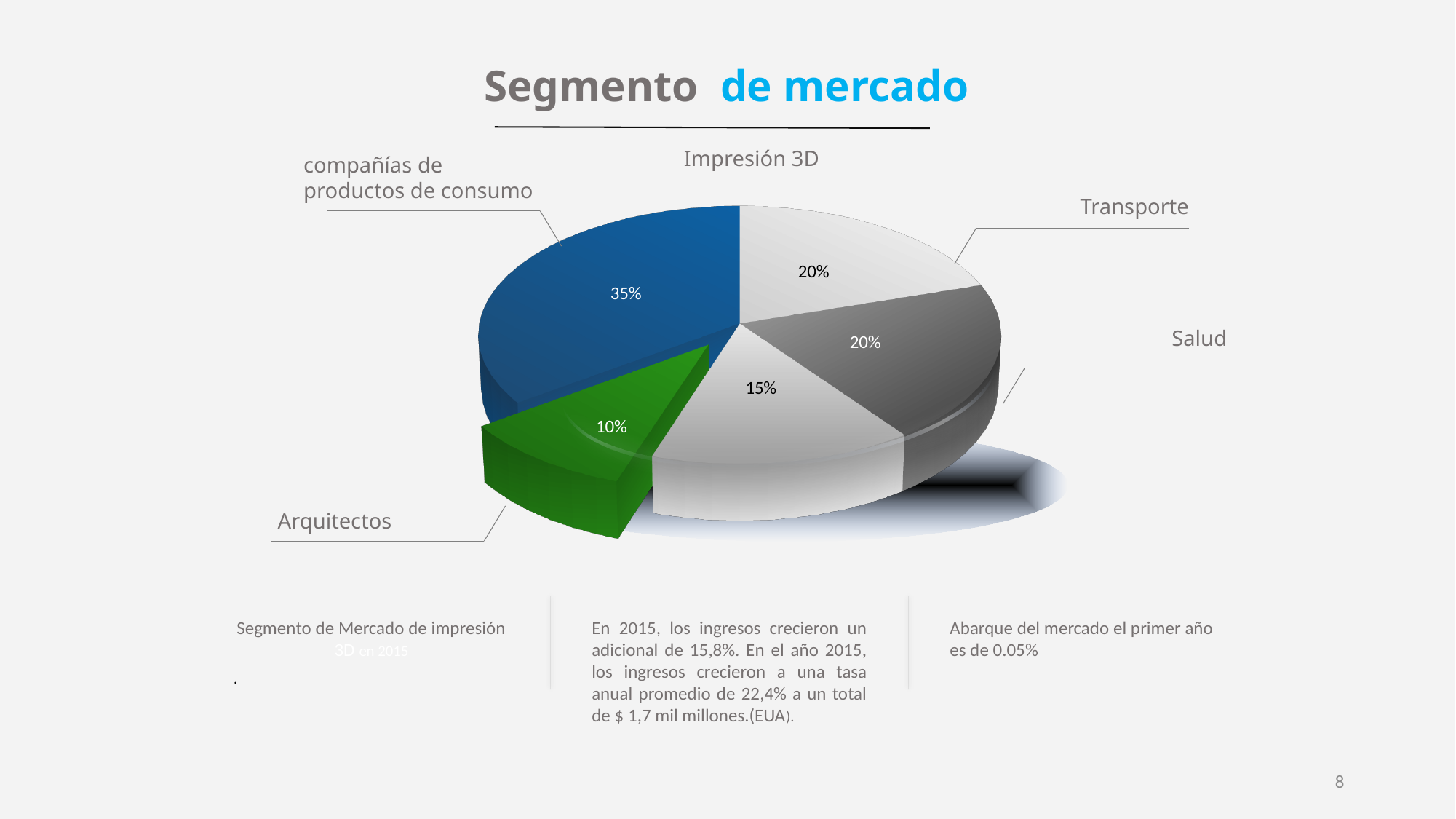
Which labelled segment has the largest share of the pie? compañías de productos de consumo What colour is the Arquitectos slice? green What share of the pie is labelled for compañías de productos de consumo? 35% How many slices does the pie chart have? 5 What kind of chart is shown on the slide? pie chart What share of the pie is labelled for Salud? 20% Which labelled segment has the smallest share of the pie? Arquitectos What is the title of the chart? Impresión 3D Which is larger, the Transporte slice or the Arquitectos slice? Transporte What is the difference in percentage points between the compañías de productos de consumo slice and the Arquitectos slice? 25 What share of the pie is labelled for Transporte? 20% What share of the pie is labelled for Arquitectos? 10%